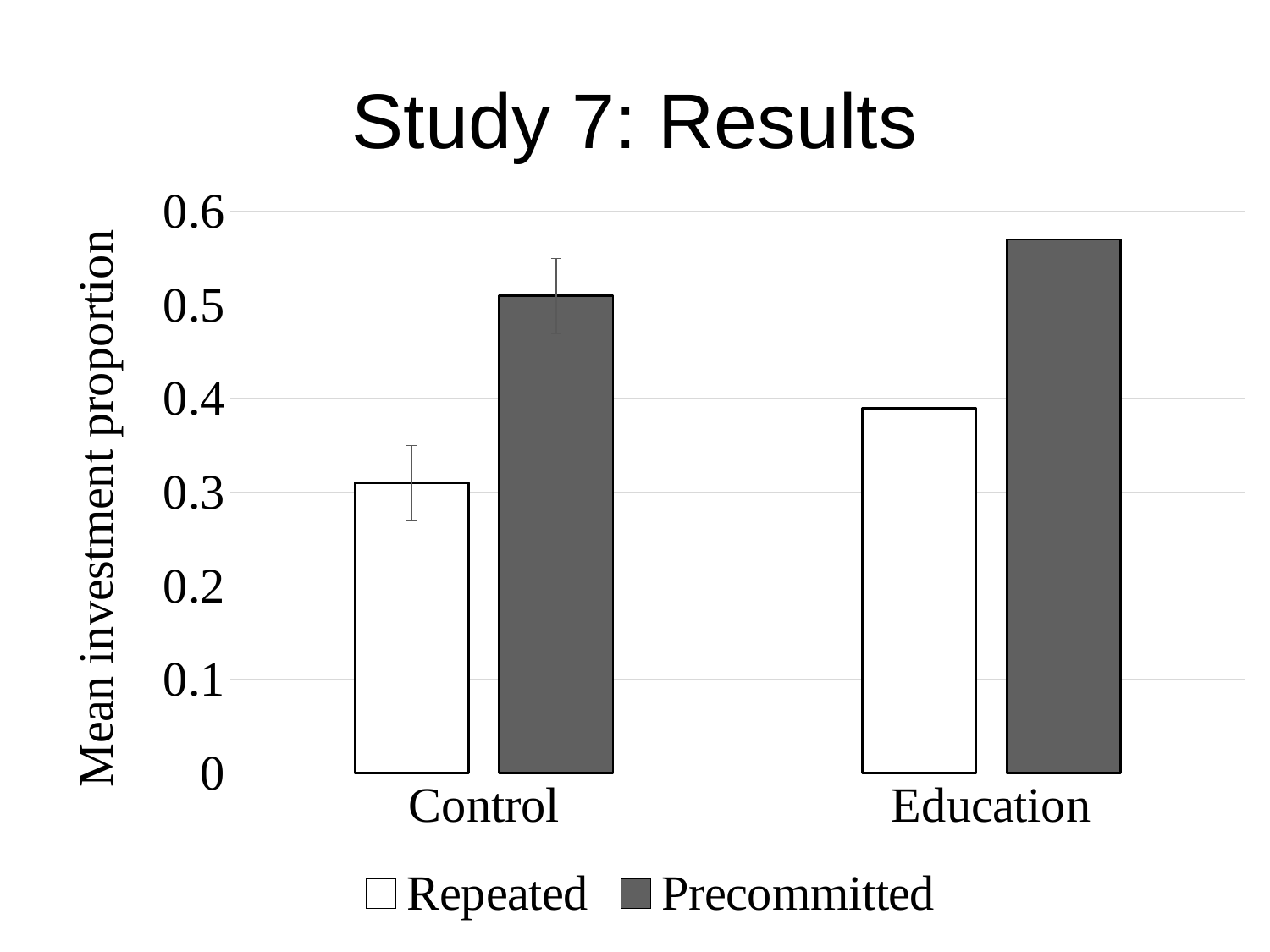
Is the value for Repeated in the Control condition greater or less than 0.4? less What kind of chart is shown on the slide? bar chart In the Education condition, which is larger: Repeated or Precommitted? Precommitted How many series does the legend list? 2 Which bar is the lowest in the chart? Repeated (Control) What is the label of the y axis? Mean investment proportion Which series has the highest bar in the chart? Precommitted (Education) Is the value for Precommitted in the Education condition greater or less than 0.5? greater How many categories are shown on the x axis? 2 For the Repeated series, which condition has the larger value: Control or Education? Education